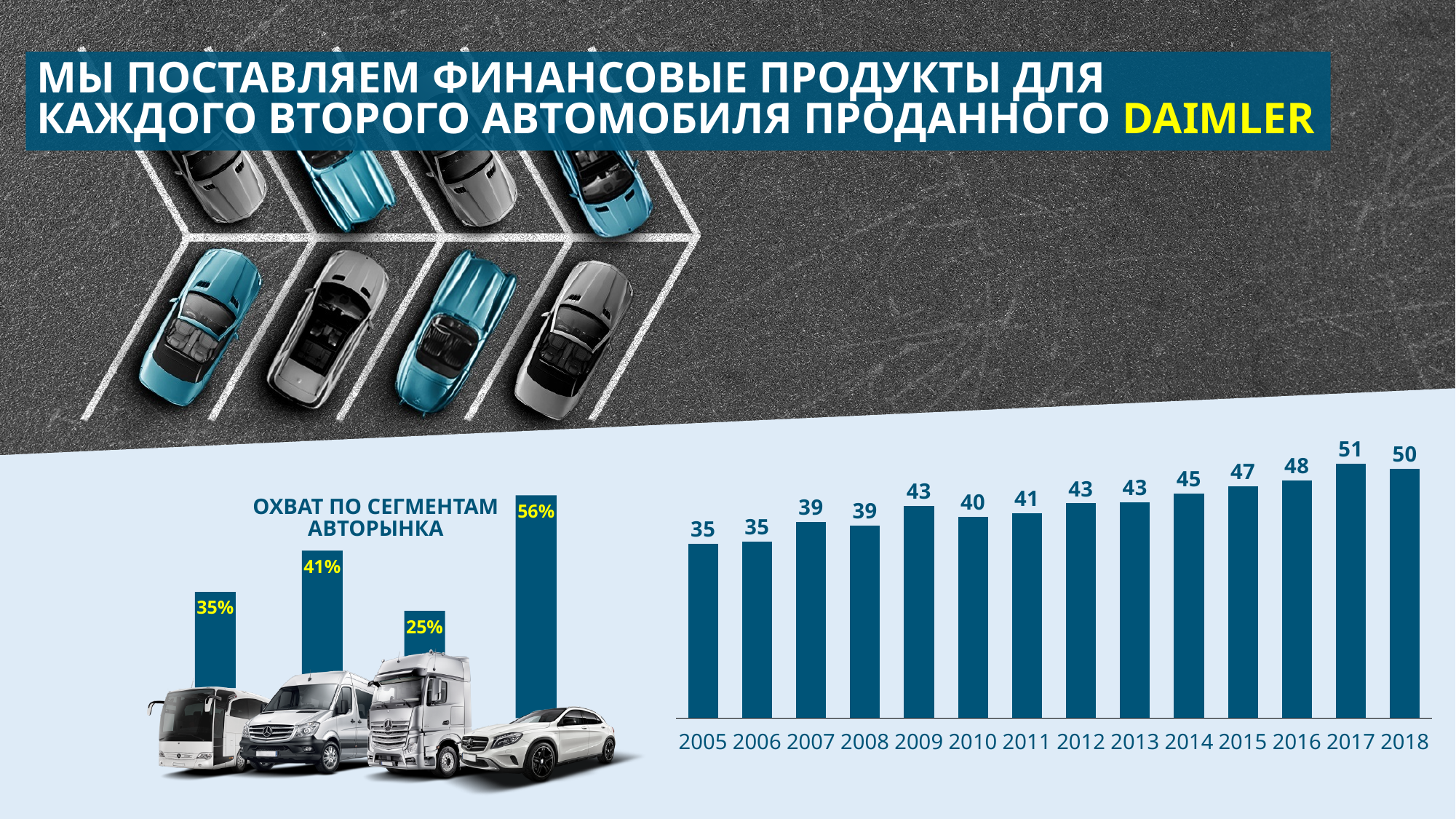
In the bar chart on the right, which year has the highest value? 2017 In the bar chart on the right, do the values generally rise or fall from 2005 to 2018? rise In the bar chart on the right, what is the value for 2017? 51 In the chart titled 'ОХВАТ ПО СЕГМЕНТАМ АВТОРЫНКА', how many bars are shown? 4 In the bar chart on the right, what is the value for 2005? 35 In the chart titled 'ОХВАТ ПО СЕГМЕНТАМ АВТОРЫНКА', what is the highest value shown? 56% In the chart titled 'ОХВАТ ПО СЕГМЕНТАМ АВТОРЫНКА', what is the lowest value shown? 25% What kind of chart is the chart on the right? bar chart In the bar chart on the right, which is larger, the value for 2014 or the value for 2011? 2014 In the bar chart on the right, what is the difference between the values for 2018 and 2005? 15 In the bar chart on the right, what is the value for 2010? 40 In the bar chart on the right, how many years are shown on the x axis? 14